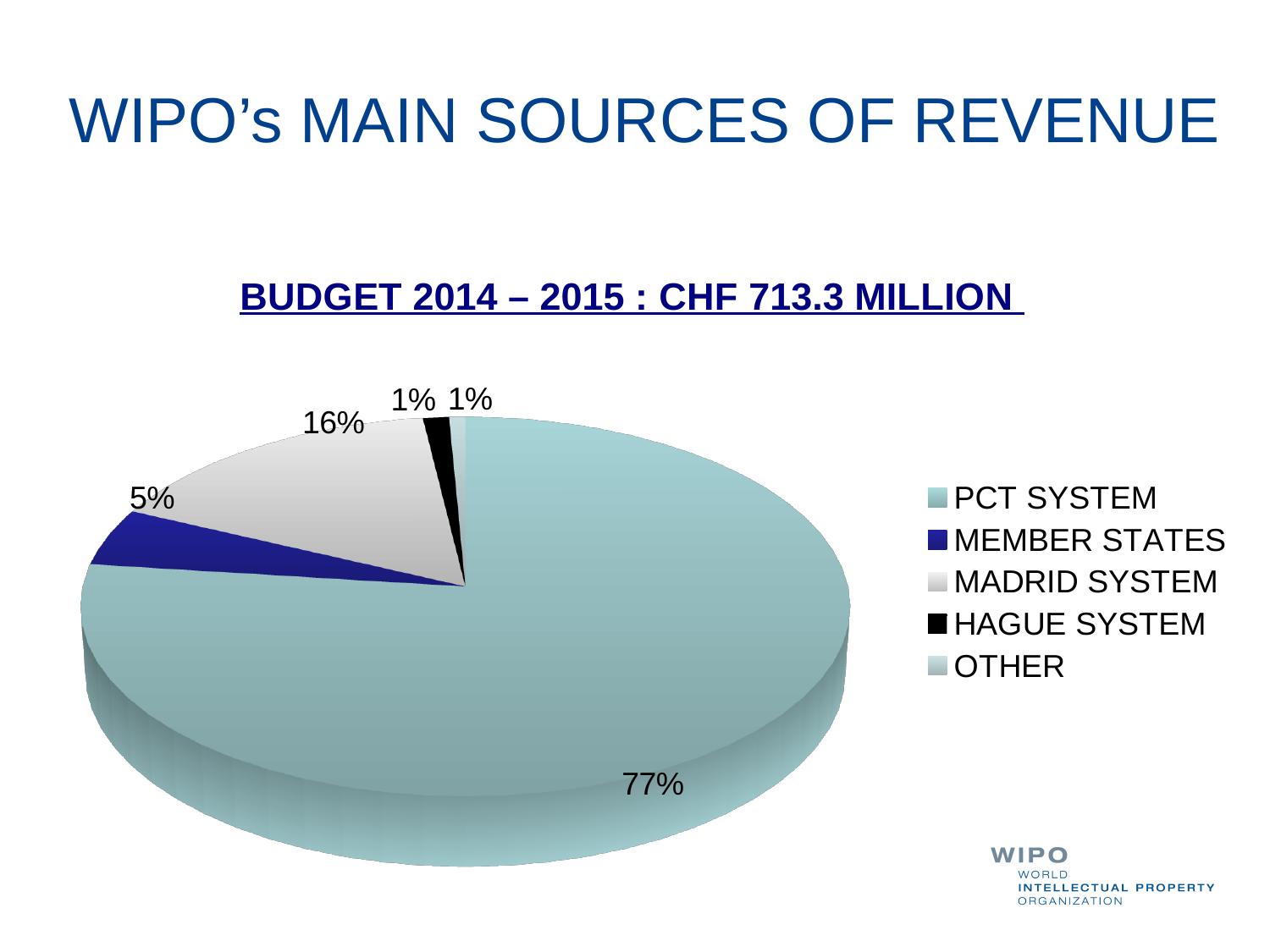
Which is larger, the MADRID SYSTEM share or the MEMBER STATES share? MADRID SYSTEM Which source of revenue has the largest share of the pie? PCT SYSTEM What share of the pie does OTHER represent? 1% What percentage of revenue comes from the PCT SYSTEM? 77% What percentage of revenue comes from the MADRID SYSTEM? 16% How many slices does the pie chart have? 5 What percentage of revenue comes from MEMBER STATES? 5% What kind of chart is shown on the slide? Pie chart What total budget figure is given in the chart heading? CHF 713.3 MILLION What is the difference in percentage points between the PCT SYSTEM and the MADRID SYSTEM shares? 61 percentage points How many entries does the legend list? 5 What percentage of revenue comes from the HAGUE SYSTEM? 1%